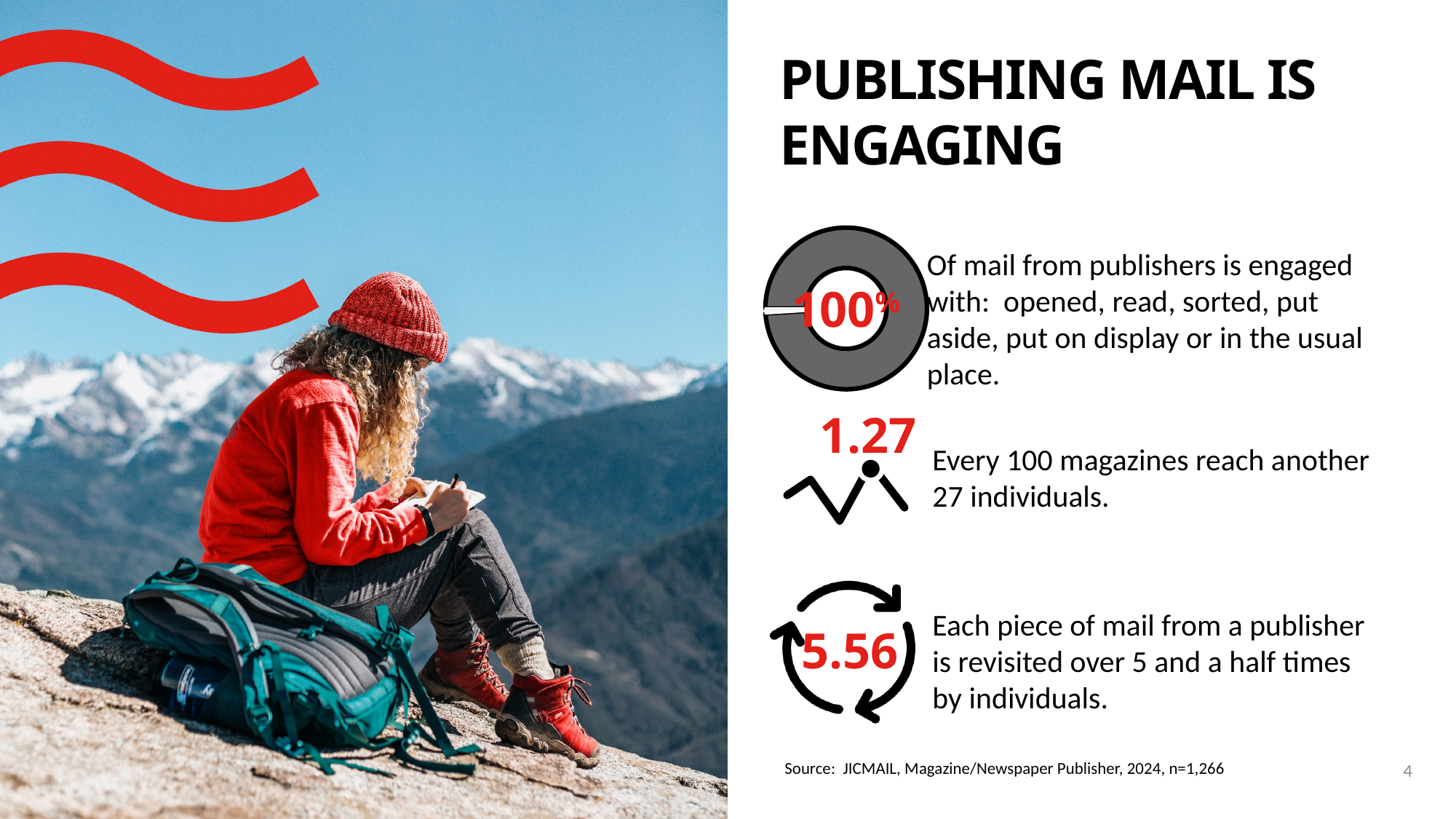
What share of mail from publishers is engaged with, according to the donut chart? 100% Is the value shown in the donut chart greater or less than 50%? greater What kind of chart is shown next to the text about mail from publishers being engaged with? Pie chart (donut) What colour is the 100% label in the donut chart? Red What colour is the ring of the donut chart? Grey What value is printed in the centre of the donut chart? 100%